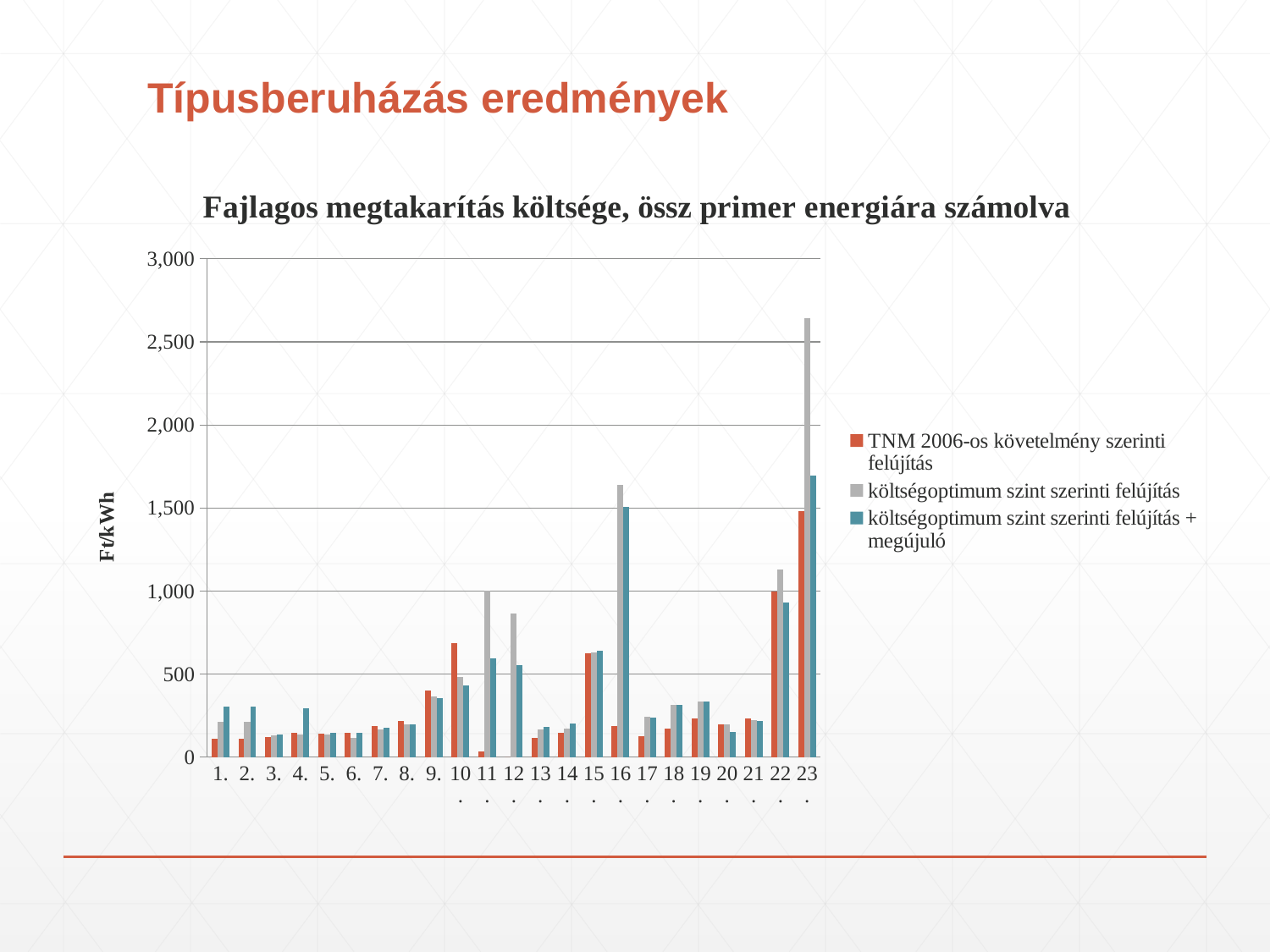
How many categories are shown along the x axis of the chart? 23 Is the value for category 10 in the 'TNM 2006-os követelmény szerinti felújítás' series greater or less than 500? greater Which category has the highest value for the 'költségoptimum szint szerinti felújítás' series? 23. What type of chart is shown on the slide? bar chart Is the value for category 12 in the 'költségoptimum szint szerinti felújítás' series greater or less than 1,000? less Which category has the lowest value for the 'TNM 2006-os követelmény szerinti felújítás' series? 12. Which category has the highest value for the 'TNM 2006-os követelmény szerinti felújítás' series? 23. How many series does the chart legend list? 3 What is the label on the vertical axis of the chart? Ft/kWh Is the value for category 23 in the 'költségoptimum szint szerinti felújítás' series greater or less than 2,500? greater For category 16, which series has the larger value: 'TNM 2006-os követelmény szerinti felújítás' or 'költségoptimum szint szerinti felújítás + megújuló'? költségoptimum szint szerinti felújítás + megújuló What is the title of the chart? Fajlagos megtakarítás költsége, össz primer energiára számolva